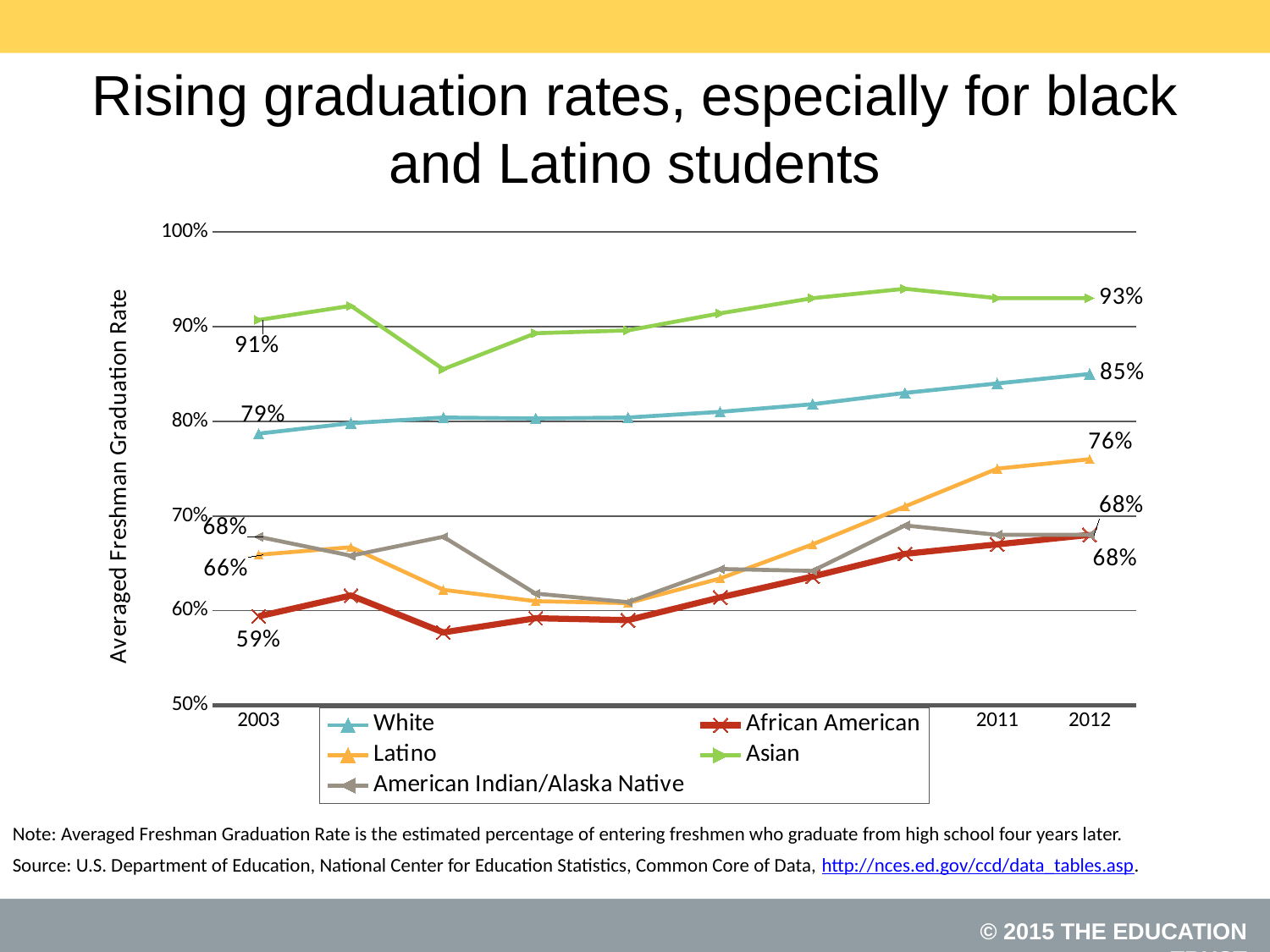
By how many percentage points did the graduation rate for African American students rise from 2003 to 2012? 9 percentage points What was the Averaged Freshman Graduation Rate for White students in 2012? 85% What was the Averaged Freshman Graduation Rate for Latino students in 2003? 66% What was the Averaged Freshman Graduation Rate for African American students in 2012? 68% Does the graduation rate for White students rise or fall from 2003 to 2012? rise What kind of chart is shown on the slide? line chart What is the title of the vertical axis? Averaged Freshman Graduation Rate Which group had the lowest graduation rate in 2003? African American What was the Averaged Freshman Graduation Rate for Asian students in 2003? 91% How many series does the legend list? 5 Which group had the highest graduation rate in 2012? Asian By how many percentage points did the graduation rate for Latino students rise from 2003 to 2012? 10 percentage points